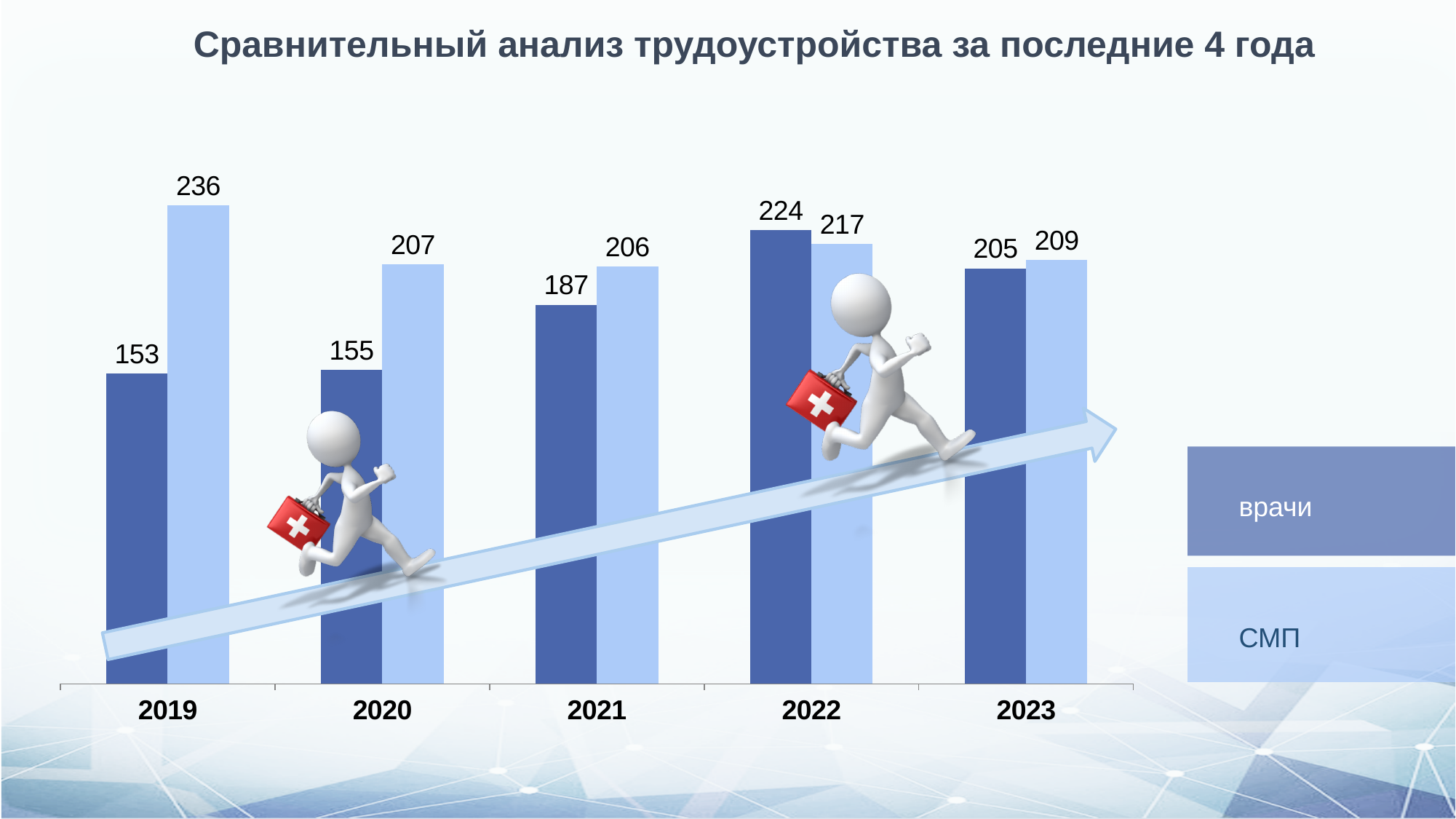
What kind of chart is shown on the slide? bar chart How many series does the legend list? 2 What is the value for врачи in 2022? 224 Does the value for врачи rise or fall from 2019 to 2022? rise Which is larger in 2022, the value for врачи or the value for СМП? врачи What is the value for СМП in 2021? 206 What is the difference between the СМП and врачи values in 2019? 83 In which year is the value for СМП highest? 2019 How many years are shown on the x axis? 5 In which year is the value for врачи lowest? 2019 What is the title of the chart? Сравнительный анализ трудоустройства за последние 4 года What is the value for врачи in 2019? 153